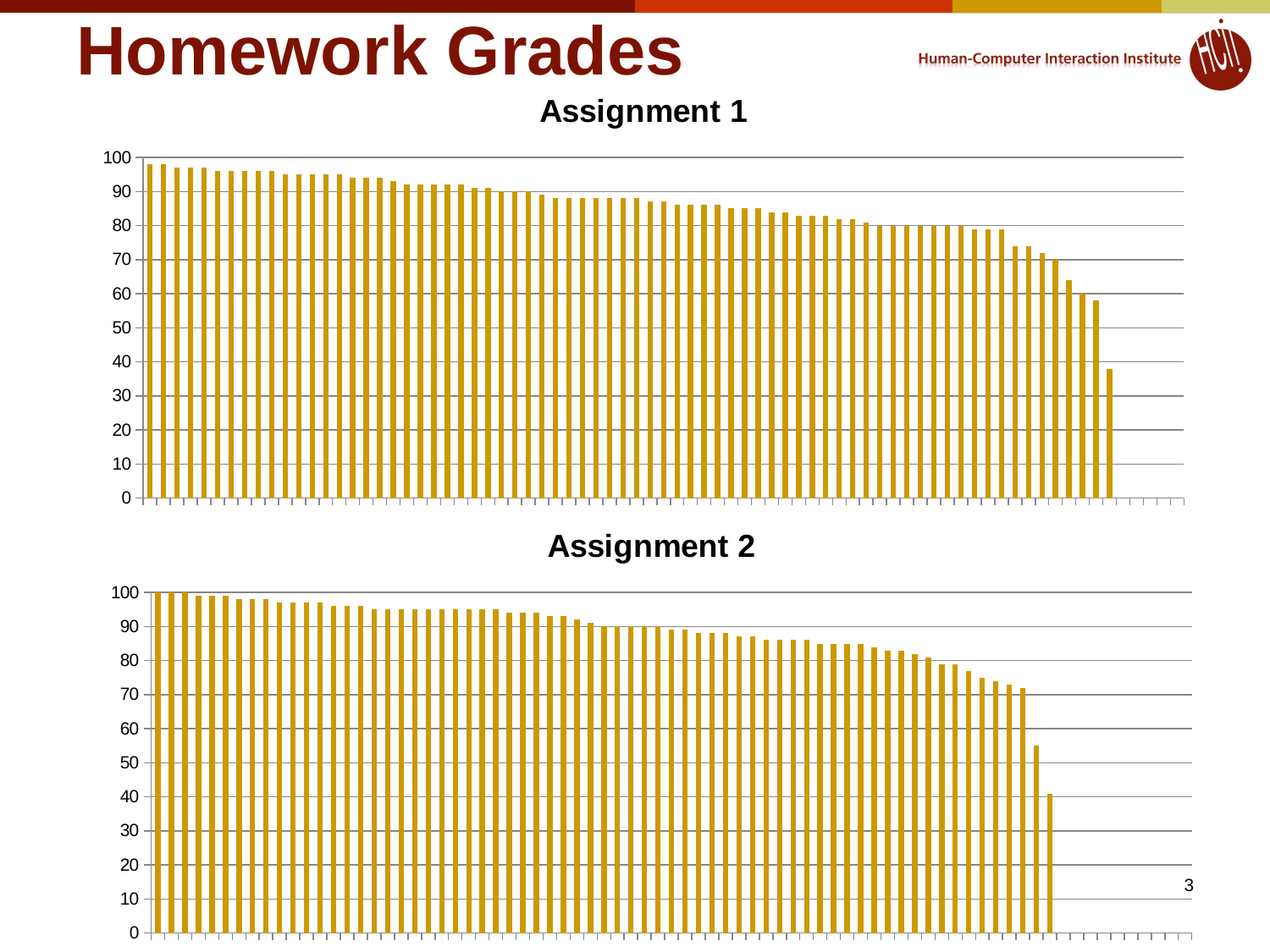
What kind of chart is the Assignment 2 chart? bar chart In the Assignment 1 chart, is the leftmost bar or the rightmost bar taller? the leftmost bar What kind of chart is the Assignment 1 chart? bar chart In the Assignment 2 chart, is the value of the second-to-last bar greater or less than 50? greater In the Assignment 1 chart, is the value of the leftmost bar greater or less than 90? greater In the Assignment 2 chart, is the value of the leftmost bar greater or less than 90? greater In the Assignment 2 chart, do the bar values rise or fall from left to right? fall What is the title of the top chart on the slide? Assignment 1 What is the highest value shown on the y axis of the Assignment 2 chart? 100 In the Assignment 1 chart, do the bar values rise or fall from left to right? fall